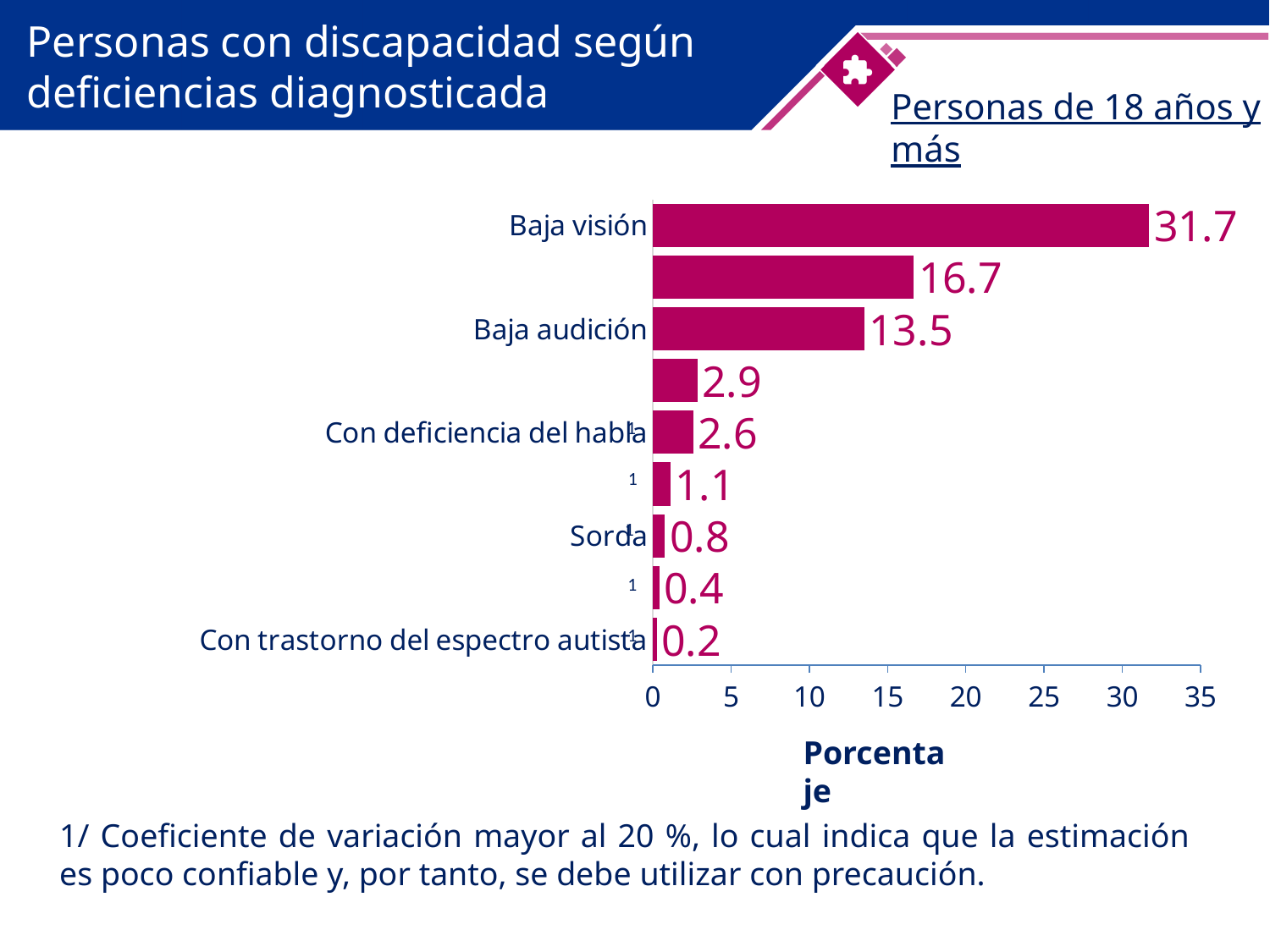
How many bars are plotted in the chart? 9 Is the value for Baja visión greater or less than 30? greater What is the value for Con deficiencia del habla? 2.6 What kind of chart is shown on the slide? Bar chart What is the difference between the values for Baja visión and Baja audición? 18.2 Which category has the lowest value? Con trastorno del espectro autista What is the value for Con trastorno del espectro autista? 0.2 What is the value for Baja visión? 31.7 What is the value for Sorda? 0.8 Which is larger, the value for Baja audición or the value for Con deficiencia del habla? Baja audición Which category has the highest value? Baja visión What is the value for Baja audición? 13.5